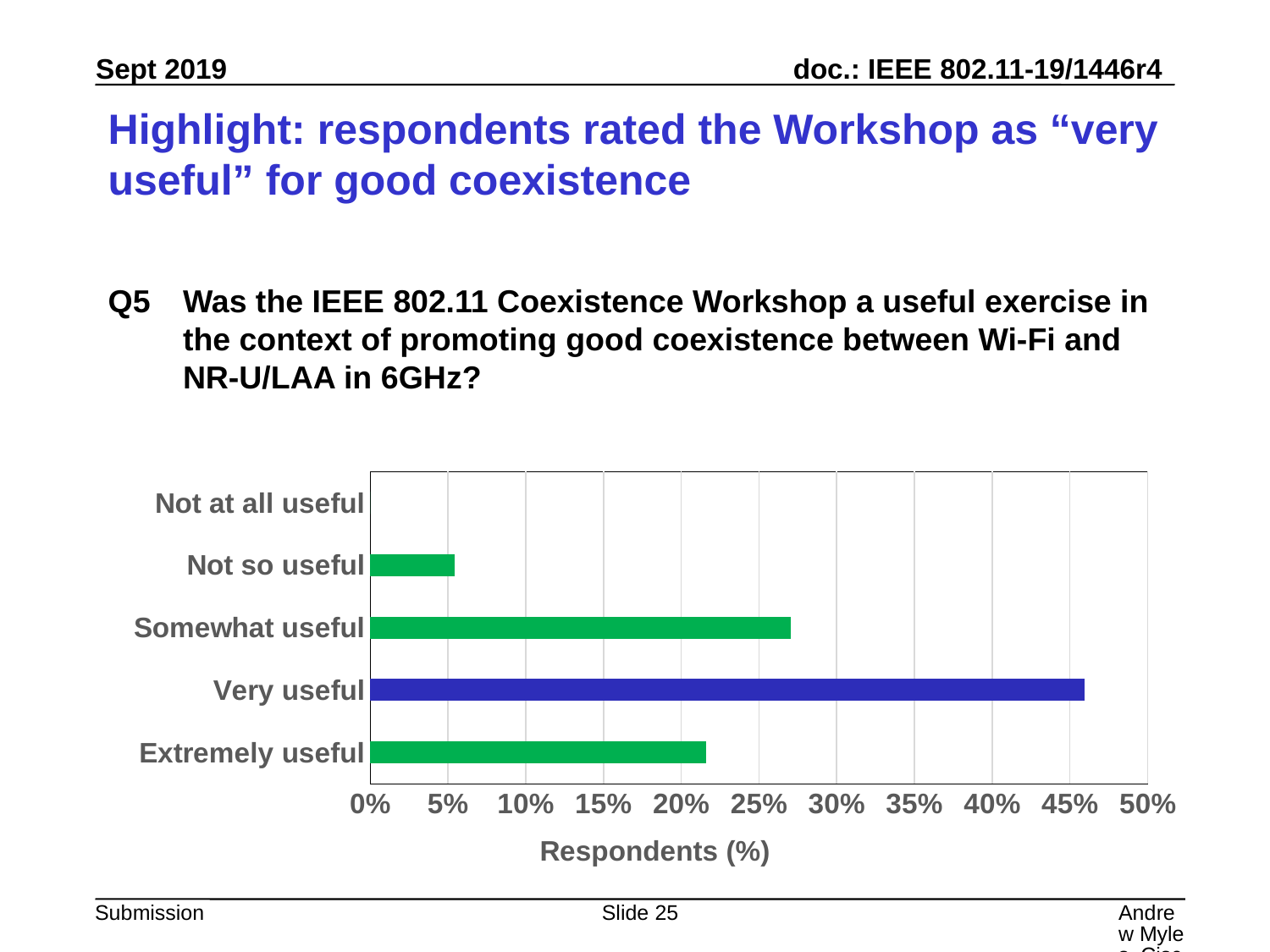
Which has a larger share of respondents, Somewhat useful or Extremely useful? Somewhat useful Which has a larger share of respondents, Not so useful or Extremely useful? Extremely useful Is the value for Somewhat useful greater or less than 25%? greater Is the value for Not so useful greater or less than 10%? less Is the value for Very useful greater or less than 40%? greater What is the label of the horizontal axis? Respondents (%) What kind of chart is shown on the slide? bar chart Which response category has the highest share of respondents? Very useful How many response categories are shown on the chart? 5 What colour is the bar for Very useful? blue Which response category has the lowest share of respondents? Not at all useful